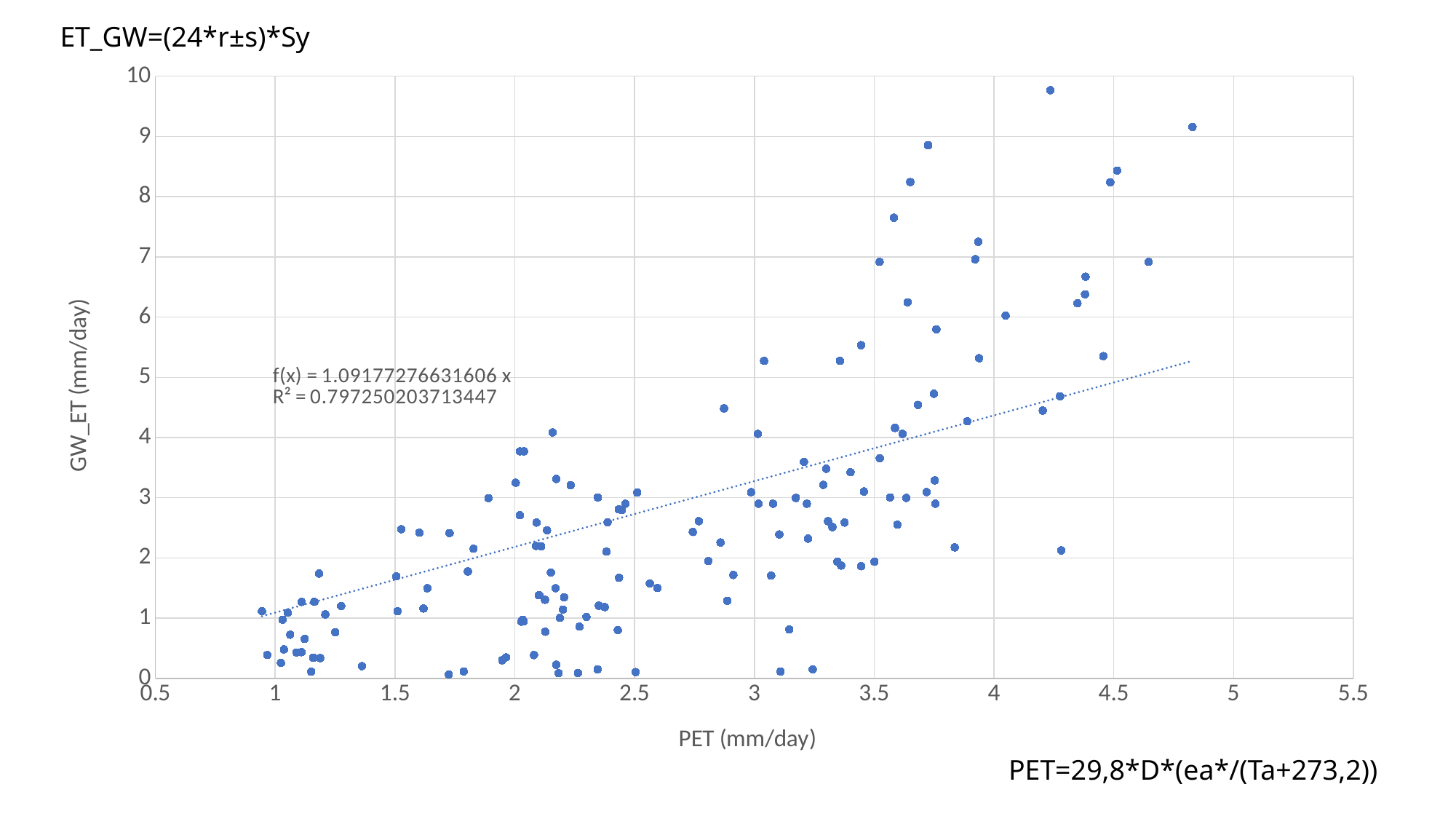
What kind of chart is shown on the slide? Scatter chart Is the GW_ET value of the point with the largest PET (near 4.8 mm/day) greater or less than 9? greater What is the trendline equation printed on the chart? f(x) = 1.09177276631606 x What is the label of the x axis? PET (mm/day) What R² value is printed on the chart? 0.797250203713447 Is the PET value of the leftmost plotted point greater or less than 1? less Is the GW_ET value of the highest plotted point greater or less than 9? greater Do the GW_ET values generally rise or fall as PET increases along the x axis? Rise What is the label of the y axis? GW_ET (mm/day)